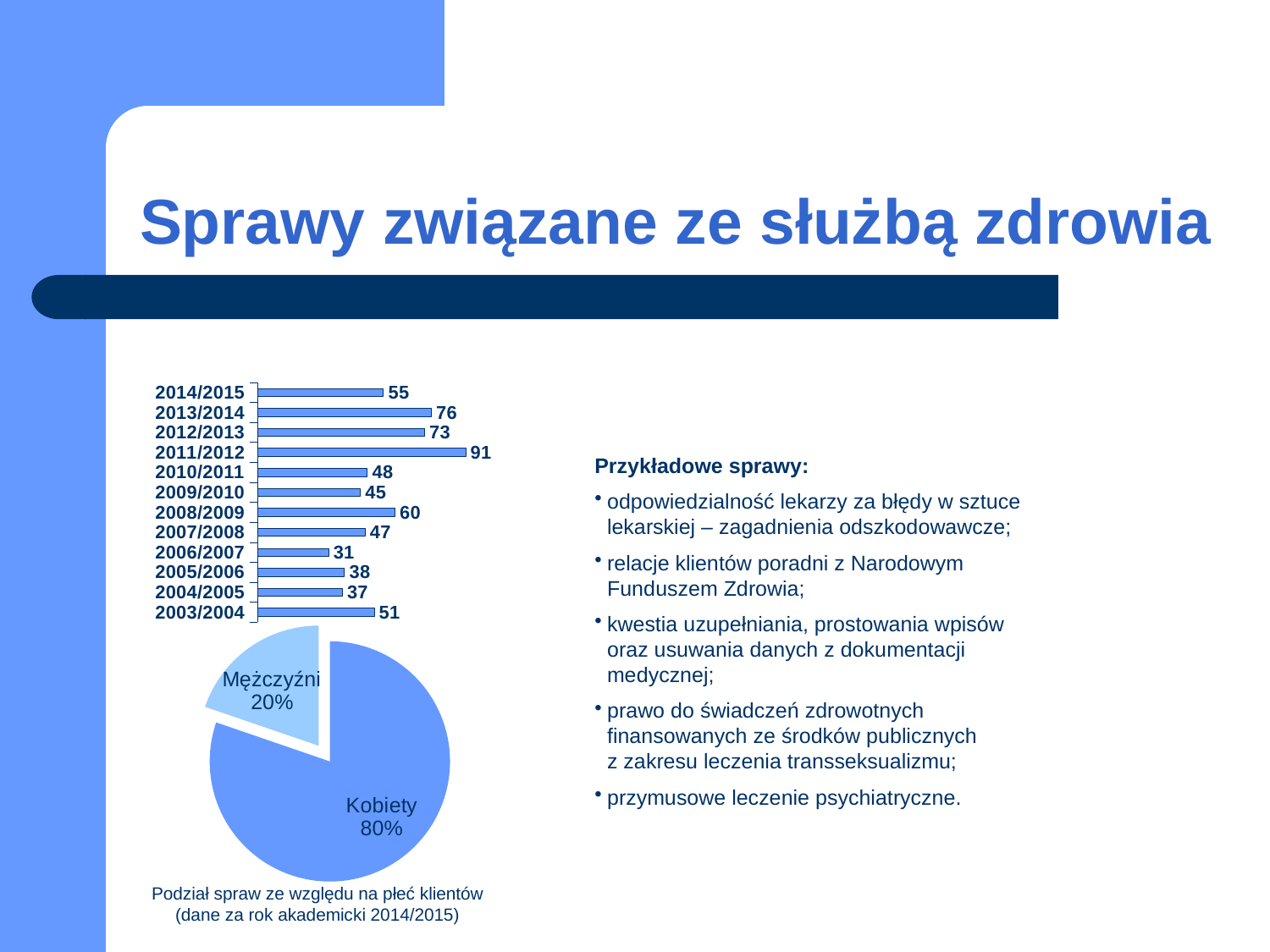
In the bar chart, which is larger: the value for 2008/2009 or the value for 2009/2010? 2008/2009 In the bar chart, what is the value for 2006/2007? 31 In the pie chart, what share is labelled Mężczyźni? 20% How many academic years are shown in the bar chart? 12 In the pie chart, what share is labelled Kobiety? 80% In the bar chart, which academic year has the highest value? 2011/2012 In the bar chart, which academic year has the lowest value? 2006/2007 What type of chart shows the values by academic year? bar chart How many slices does the pie chart have? 2 In the bar chart, what is the value for 2011/2012? 91 In the bar chart, what is the difference between the values for 2013/2014 and 2014/2015? 21 What is the caption below the pie chart? Podział spraw ze względu na płeć klientów (dane za rok akademicki 2014/2015)